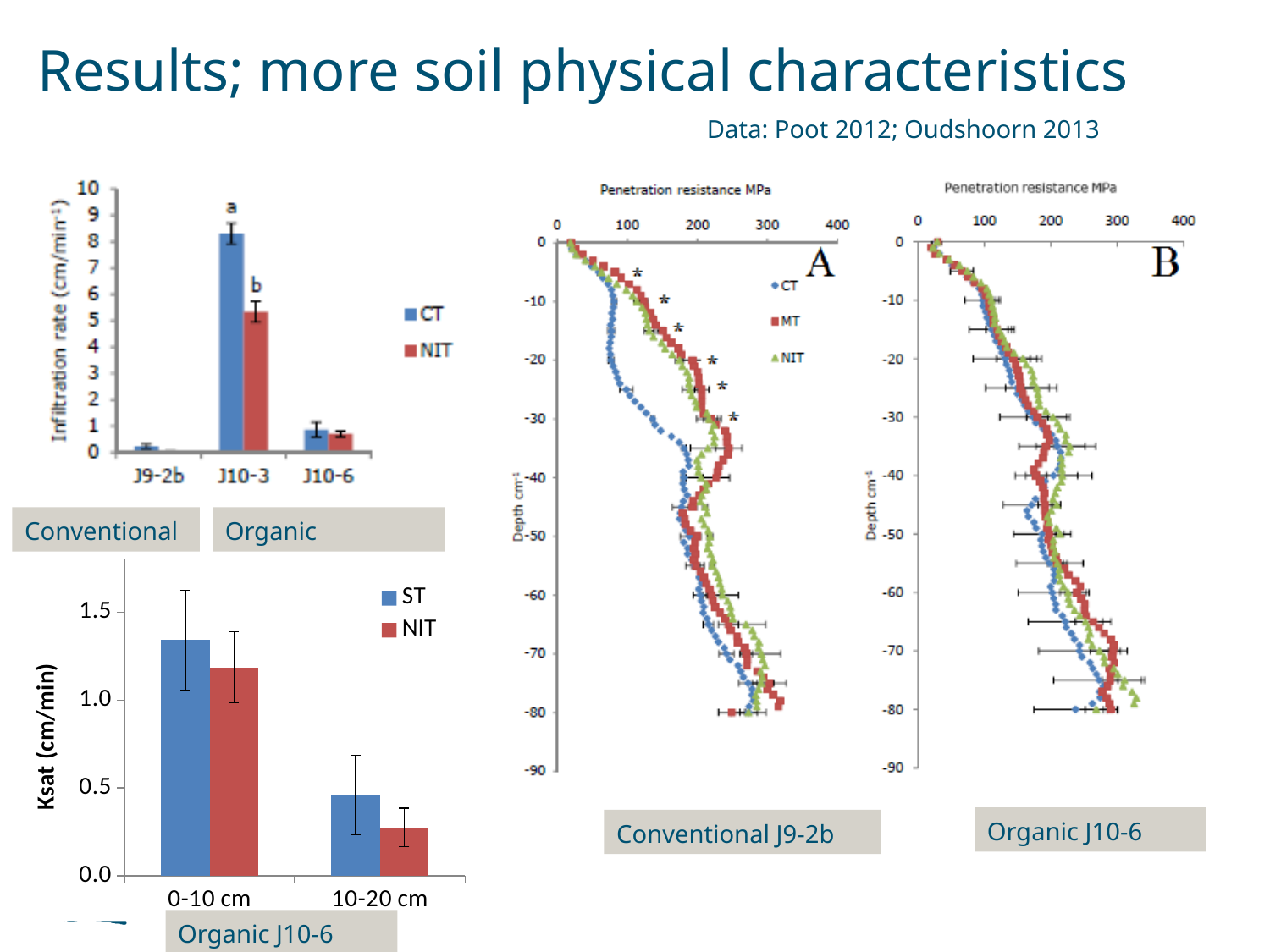
In the infiltration rate bar chart (top left), which site has the highest infiltration rate for CT? J10-3 In the infiltration rate bar chart (top left), which is larger at J10-3, CT or NIT? CT In the infiltration rate bar chart (top left), which site has the lowest infiltration rate for CT? J9-2b How many series does the legend of the infiltration rate bar chart (top left) list? 2 In the Ksat chart (bottom left), is the NIT value for 10-20 cm greater or less than 0.5? less In the Ksat chart (bottom left), which is larger at 0-10 cm, ST or NIT? ST What kind of chart is the Ksat chart at the bottom left? Bar chart In the Ksat chart (bottom left), is the ST value for 0-10 cm greater or less than 1.0? greater How many series does the legend of penetration resistance chart A list? 3 In the infiltration rate bar chart (top left), is the CT value for J10-3 greater or less than 7? greater How many sites are shown on the x axis of the infiltration rate bar chart (top left)? 3